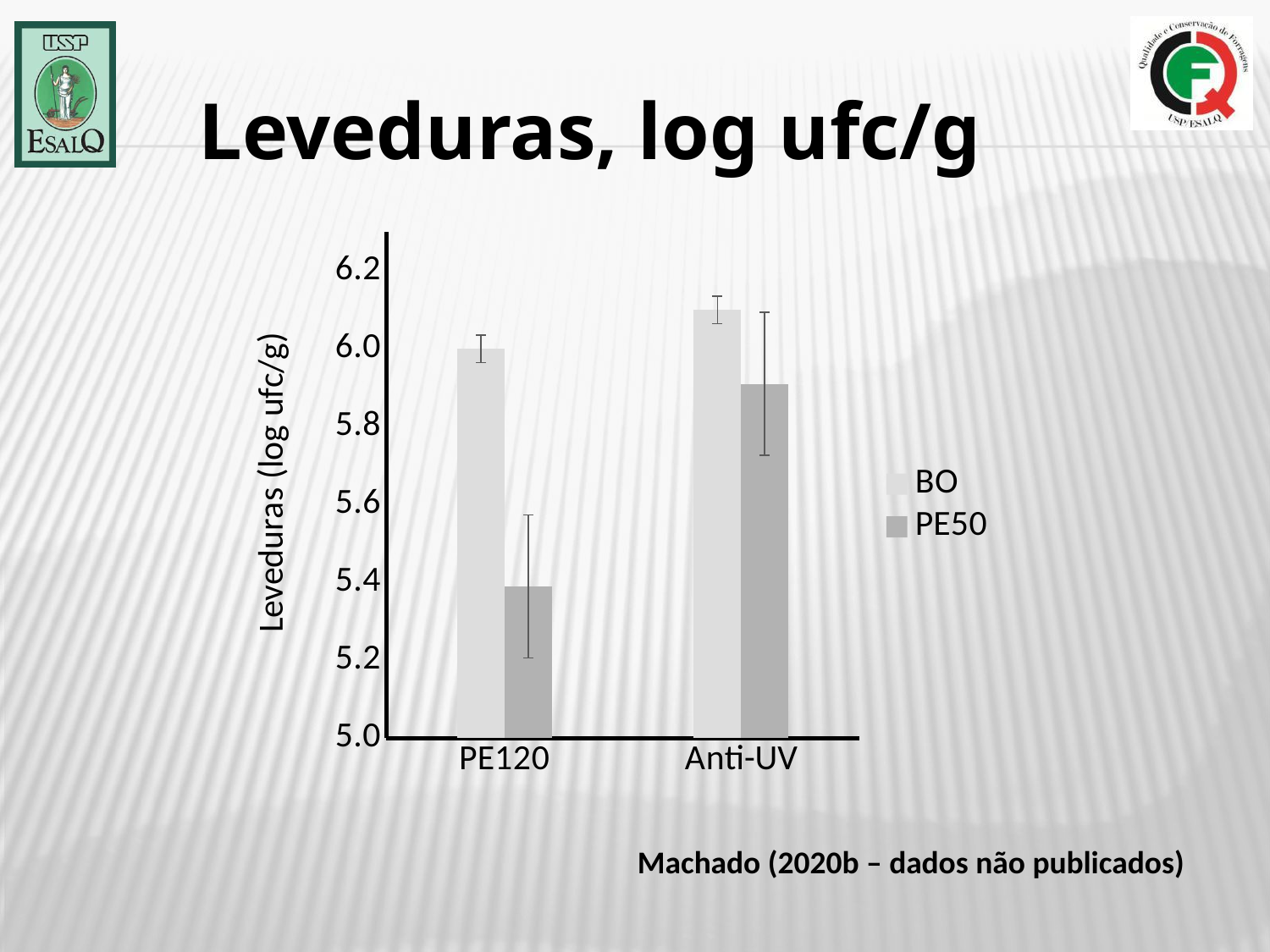
Is the PE50 value for PE120 greater or less than 5.2? greater Which bar is the lowest in the chart? PE50 at PE120 Is the PE50 value for PE120 greater or less than 5.6? less How many categories are shown on the x axis? 2 How many series does the legend list? 2 Is the PE50 value for Anti-UV greater or less than 5.8? greater Which is larger: the PE50 value for PE120 or the PE50 value for Anti-UV? PE50 for Anti-UV What kind of chart is shown on the slide? bar chart What are the two entries in the legend? BO and PE50 Within the PE120 category, which series has the larger value, BO or PE50? BO What is the label of the y axis? Leveduras (log ufc/g)